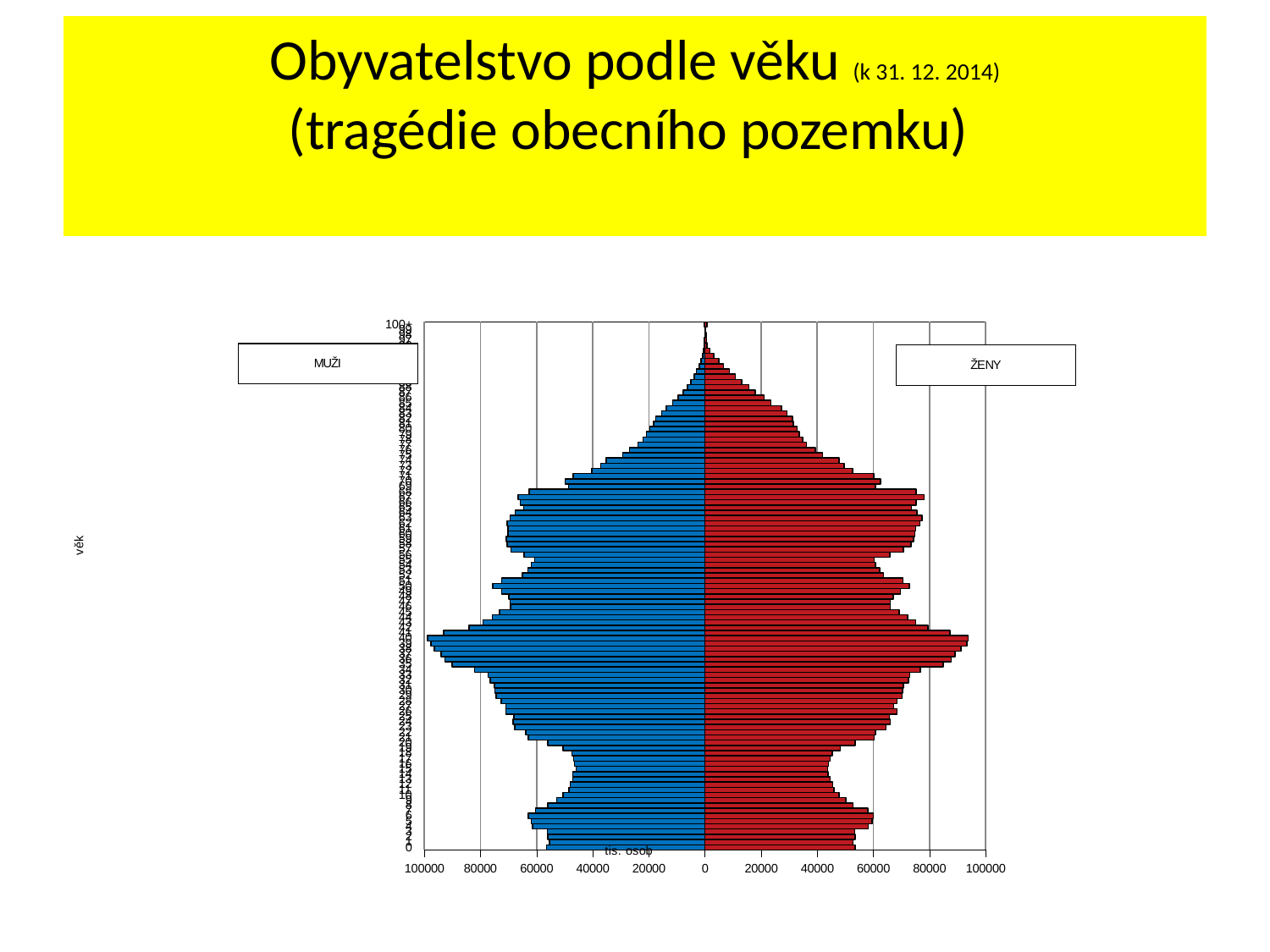
Is the longest bar for MUŽI greater or less than 80000? greater Which colour represents MUŽI in the chart? blue At the oldest ages near the top of the chart, which group has the longer bars, MUŽI or ŽENY? ŽENY Is the bar for MUŽI at age 0 (bottom of the chart) greater or less than 80000? less Is the bar for ŽENY at age 0 (bottom of the chart) greater or less than 40000? greater To what date does the chart title say the data refer? 31. 12. 2014 What kind of chart is shown on the slide? bar chart How many groups (series) does the chart show? 2